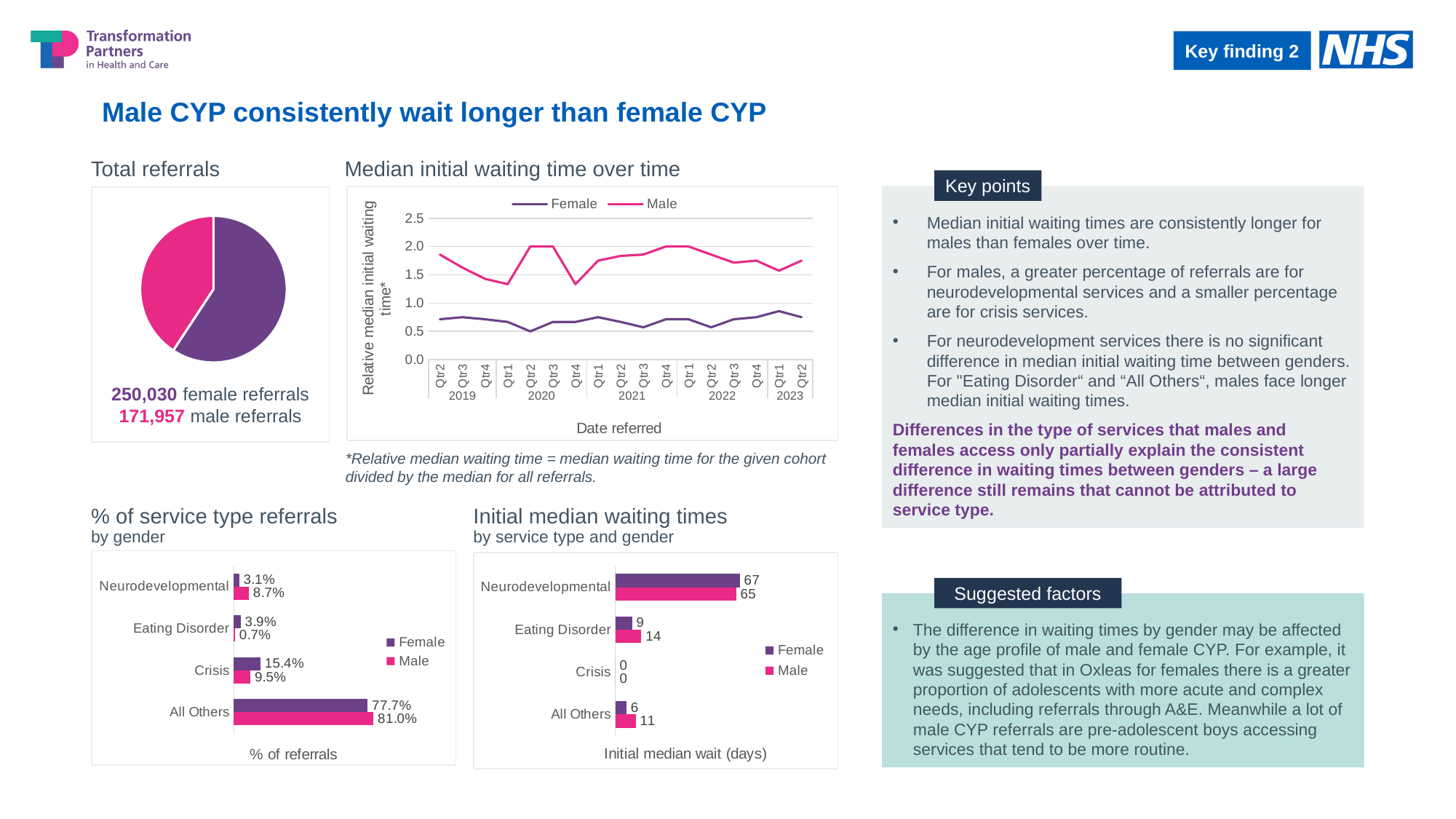
In the 'Median initial waiting time over time' chart, is the Female value at Qtr2 2020 greater or less than 1.0? less In the 'Initial median waiting times by service type and gender' chart, which is larger for All Others, the Female or the Male value? Male In the 'Median initial waiting time over time' chart, is the Male value at Qtr2 2019 greater or less than 1.5? greater In the '% of service type referrals by gender' chart, which service type has the highest Female value? All Others What kind of chart is 'Median initial waiting time over time'? Line chart In the 'Total referrals' pie chart, how many more female referrals are there than male referrals? 78,073 In the 'Total referrals' pie chart, how many female referrals are there? 250,030 How many service type categories are shown in the 'Initial median waiting times by service type and gender' chart? 4 In the '% of service type referrals by gender' chart, what is the difference between the Male and Female values for Neurodevelopmental? 5.6% In the '% of service type referrals by gender' chart, what is the Male value for Neurodevelopmental? 8.7% In the 'Initial median waiting times by service type and gender' chart, what is the Male value for Eating Disorder? 14 In the 'Median initial waiting time over time' chart, how many series does the legend list? 2